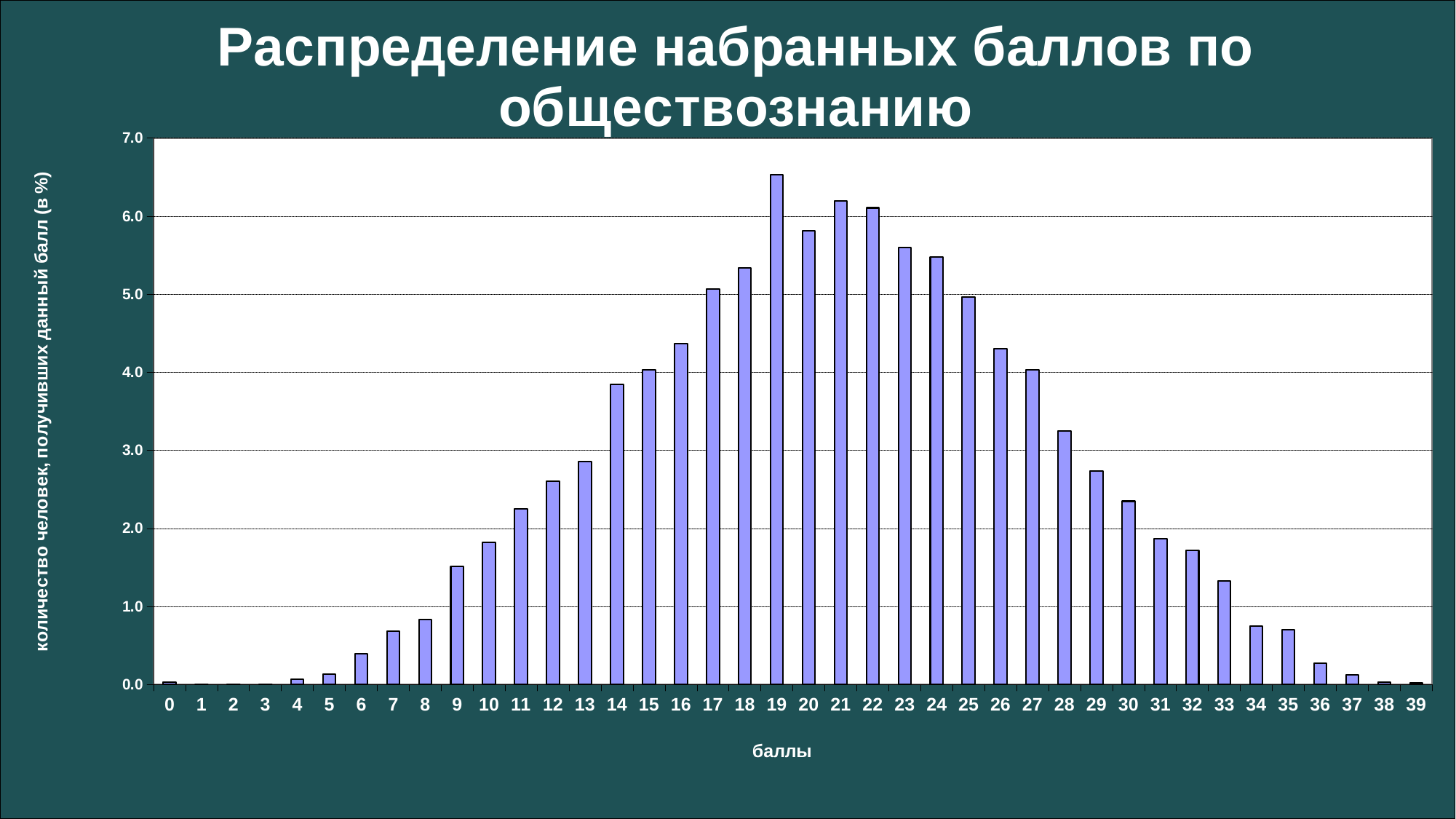
Which is larger, the value for score 14 or the value for score 26? 26 Is the value for score 20 greater or less than 6.0? less Which is larger, the value for score 19 or the value for score 22? 19 What kind of chart is shown on the slide? bar chart Is the value for score 9 greater or less than 1.0? greater What is the title of the chart? Распределение набранных баллов по обществознанию Do the values rise or fall as the score goes from 19 to 39? fall What is the label of the x axis? баллы How many score categories are shown along the x axis? 40 Which score has the highest percentage of people? 19 Is the value for score 19 greater or less than 6.0? greater